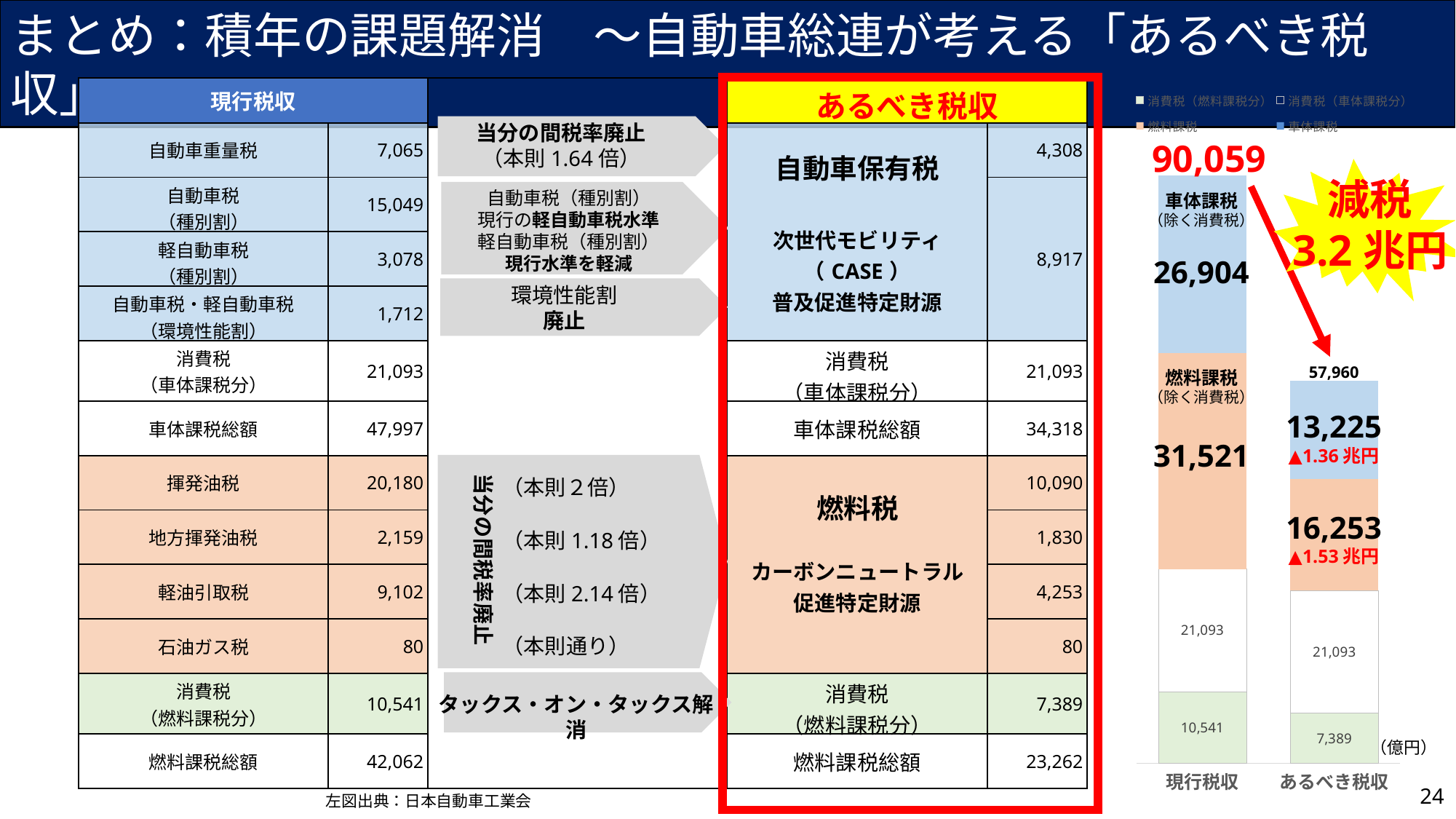
In the stacked bar chart on the right, what is the total for the あるべき税収 bar? 57,960 In the stacked bar chart on the right, which bar has the larger total, 現行税収 or あるべき税収? 現行税収 In the stacked bar chart on the right, what is the 消費税（車体課税分） value for あるべき税収? 21,093 What kind of chart is shown on the right of the slide? Stacked bar chart In the stacked bar chart on the right, what unit is shown next to the bars? 億円 In the stacked bar chart on the right, how many series does the legend list? 4 In the stacked bar chart on the right, what is the difference between the 車体課税 values for 現行税収 and あるべき税収? 13,679 In the stacked bar chart on the right, what is the 燃料課税 value for あるべき税収? 16,253 In the stacked bar chart on the right, what is the total for the 現行税収 bar? 90,059 In the stacked bar chart on the right, how many bars are plotted? 2 In the stacked bar chart on the right, what is the 消費税（燃料課税分） value for 現行税収? 10,541 In the stacked bar chart on the right, what is the 車体課税 value for 現行税収? 26,904